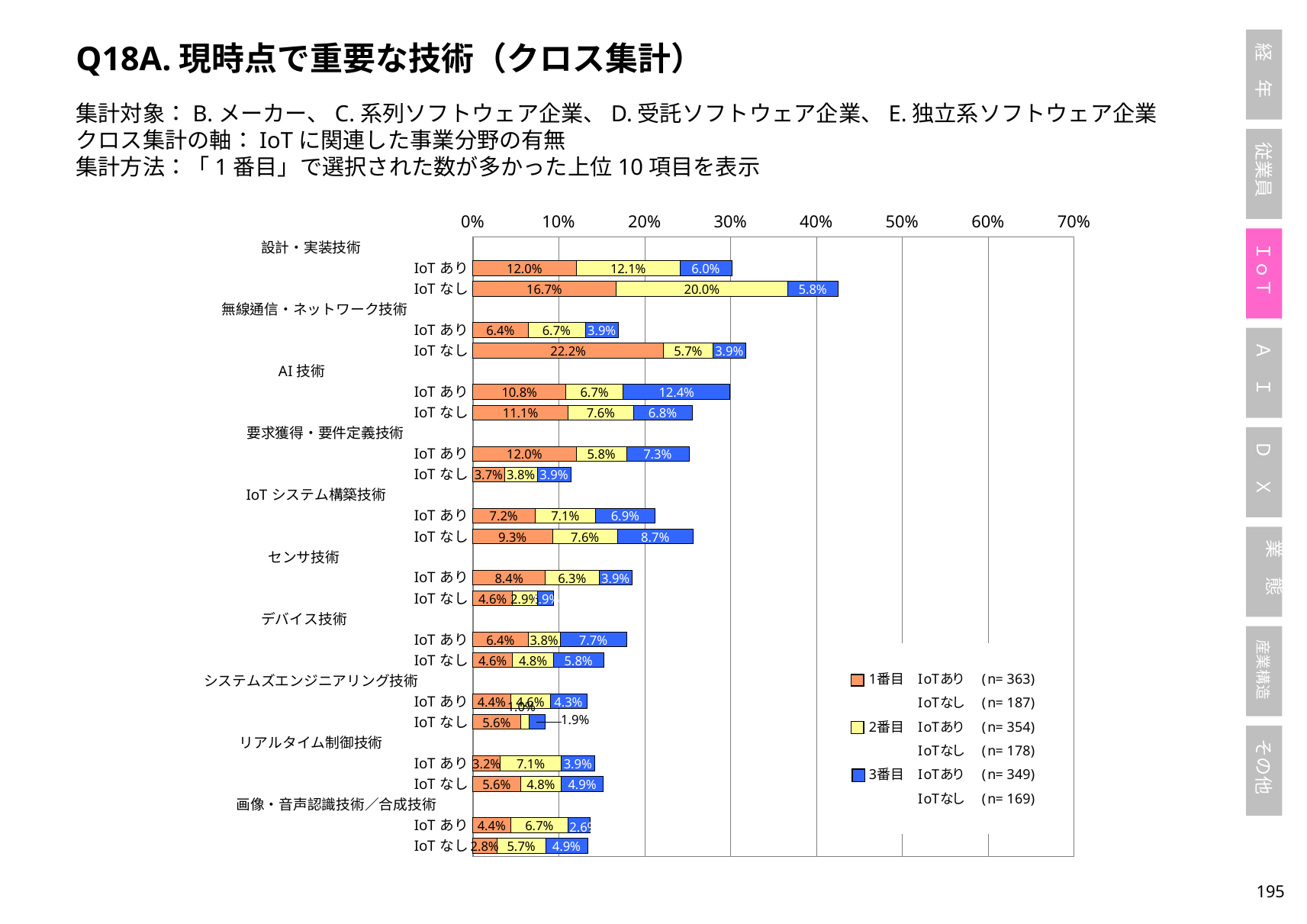
How many technology categories are shown in the chart? 10 How many series does the legend list? 3 What is the sample size (n) for 1番目 IoTあり shown in the legend? 363 What is the 3番目 value for AI技術 in the IoTあり row? 12.4% What is the difference between the 1番目 values for 設計・実装技術 IoTなし (16.7%) and IoTあり (12.0%)? 4.7 percentage points What is the total of the stacked bar for 設計・実装技術 IoTなし? 42.5% Which row has the highest 1番目 value? 無線通信・ネットワーク技術 IoTなし Which is larger: the 1番目 value for AI技術 IoTあり or for AI技術 IoTなし? AI技術 IoTなし (11.1%) What is the 1番目 value for 無線通信・ネットワーク技術 in the IoTなし row? 22.2% What kind of chart is shown on the slide? Stacked bar chart Is the total stacked bar for 設計・実装技術 IoTなし greater or less than 40%? greater What is the 2番目 value for 設計・実装技術 in the IoTなし row? 20.0%